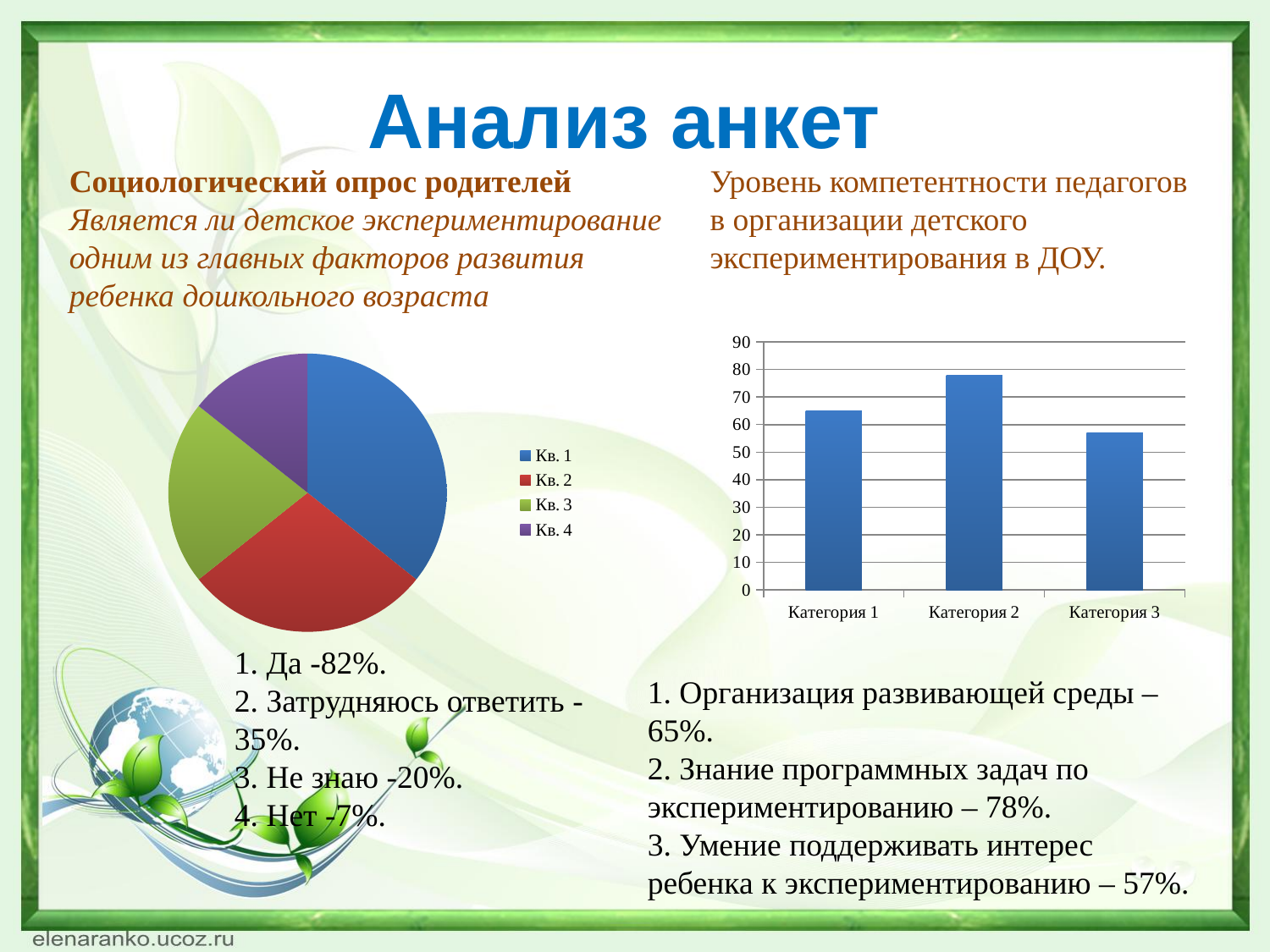
What kind of chart is the chart on the right of the slide? bar chart What kind of chart is the chart on the left of the slide? pie chart In the bar chart on the right, which category has the highest bar? Категория 2 In the bar chart on the right, is the value for Категория 3 greater or less than 60? less In the pie chart on the left, which legend entry has the largest slice? Кв. 1 In the bar chart on the right, how many categories are shown on the x axis? 3 In the bar chart on the right, which category has the lowest bar? Категория 3 In the pie chart on the left, which slice is larger, Кв. 1 or Кв. 2? Кв. 1 In the pie chart on the left, which legend entry has the smallest slice? Кв. 4 In the pie chart on the left, how many entries does the legend list? 4 In the bar chart on the right, is the value for Категория 1 greater or less than 60? greater In the bar chart on the right, is the value for Категория 2 greater or less than 70? greater